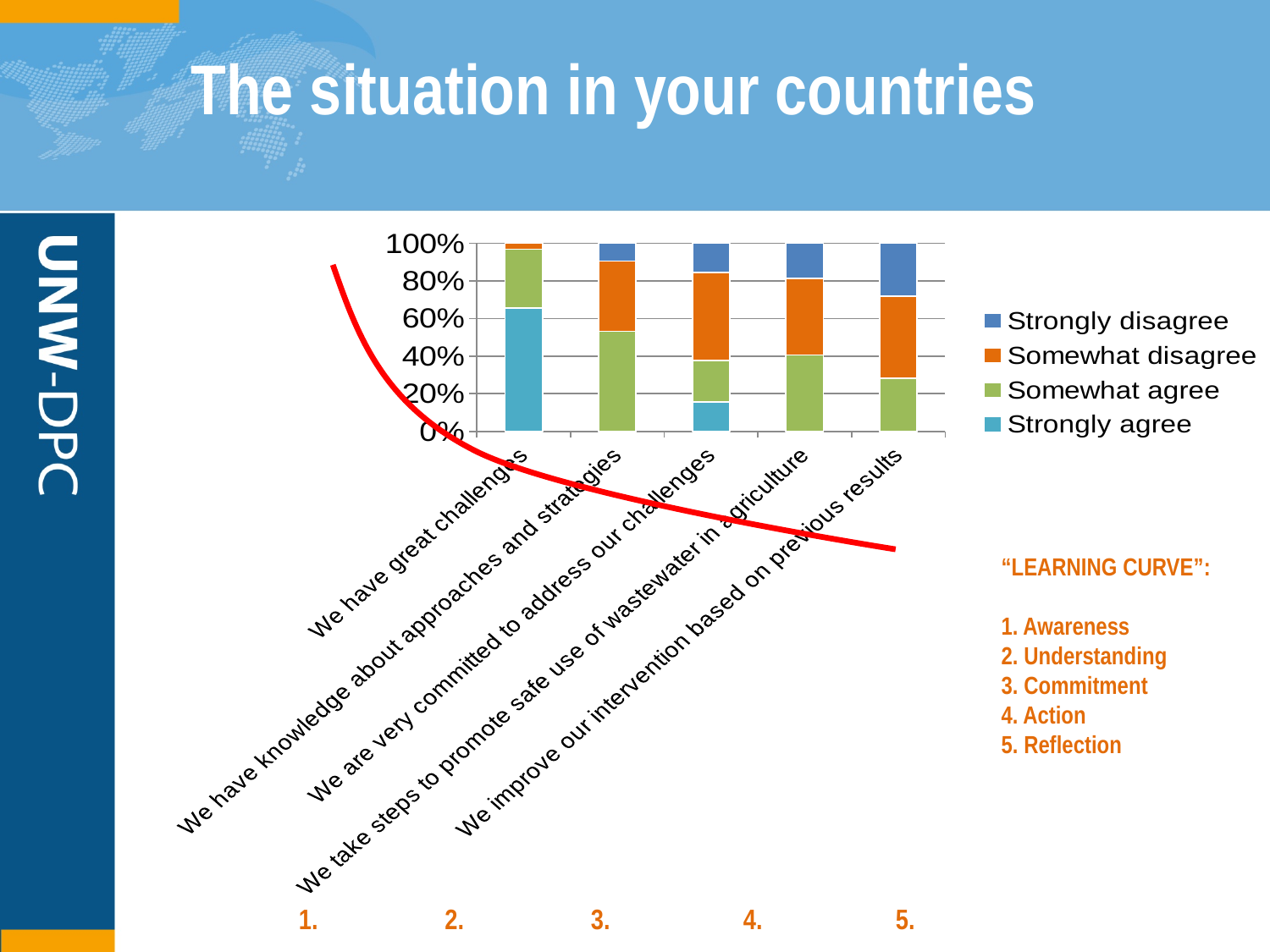
Which category has the largest 'Strongly disagree' share? We improve our intervention based on previous results Is the 'Somewhat agree' share for 'We have knowledge about approaches and strategies' greater or less than 40%? greater Which legend entry is shown in orange? Somewhat disagree Which category has the largest 'Strongly agree' share? We have great challenges Which category has a larger 'Strongly agree' share: 'We have great challenges' or 'We are very committed to address our challenges'? We have great challenges How many series does the chart's legend list? 4 Does the 'Strongly disagree' share rise or fall moving from the first category to the last along the x axis? Rise What is the title of the slide containing the chart? The situation in your countries Is the 'Strongly agree' share for 'We have great challenges' greater or less than 60%? greater Is the 'Strongly agree' share for 'We are very committed to address our challenges' greater or less than 20%? less What kind of chart is shown on the slide? Stacked bar chart How many categories (statements) are plotted along the x axis of the chart? 5